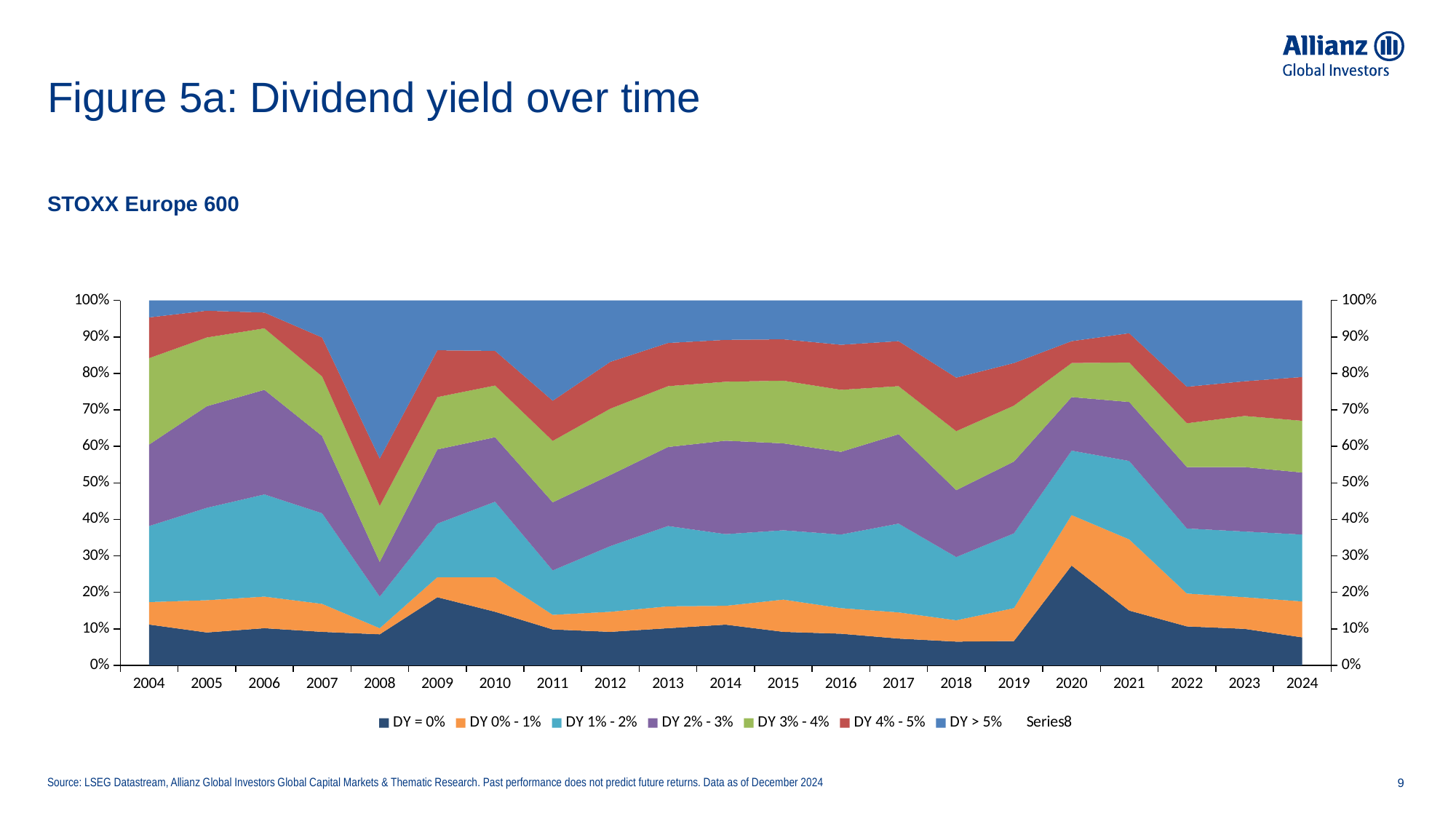
Does the share of DY > 5% rise or fall between 2004 and 2008? rise What kind of chart is shown on the slide? Stacked area chart Is the share of DY = 0% in 2020 greater or less than 20%? greater In which year is the share of DY = 0% companies the highest? 2020 Which index does the chart cover, according to the subtitle? STOXX Europe 600 Which year has the larger share of DY = 0%: 2009 or 2020? 2020 What is the first year shown on the x axis? 2004 Is the share of DY = 0% in 2008 greater or less than 10%? less How many years are plotted along the x axis of the chart? 21 Which year has the larger share of DY > 5%: 2006 or 2008? 2008 How many entries does the chart's legend list? 8 What is the title of the figure on the slide? Figure 5a: Dividend yield over time